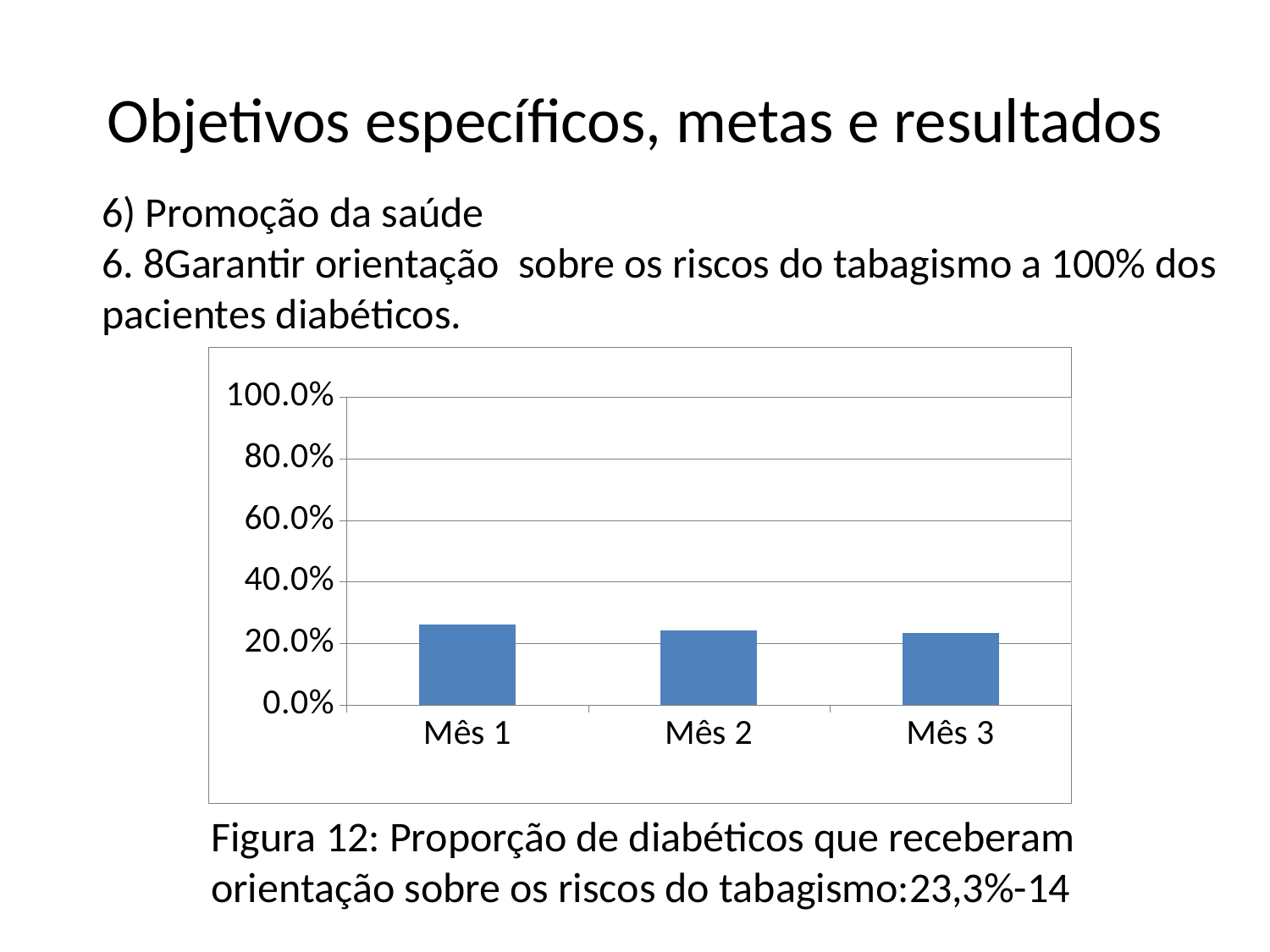
Is the value for Mês 2 greater or less than 20.0%? greater How many categories (months) are plotted on the chart? 3 Do the values rise or fall from Mês 1 to Mês 3? fall Is the value for Mês 3 greater or less than 40.0%? less What kind of chart is shown on the slide? bar chart What is the highest value shown on the vertical axis of the chart? 100.0% What is the label of the first category on the horizontal axis? Mês 1 Is the value for Mês 1 greater or less than 40.0%? less